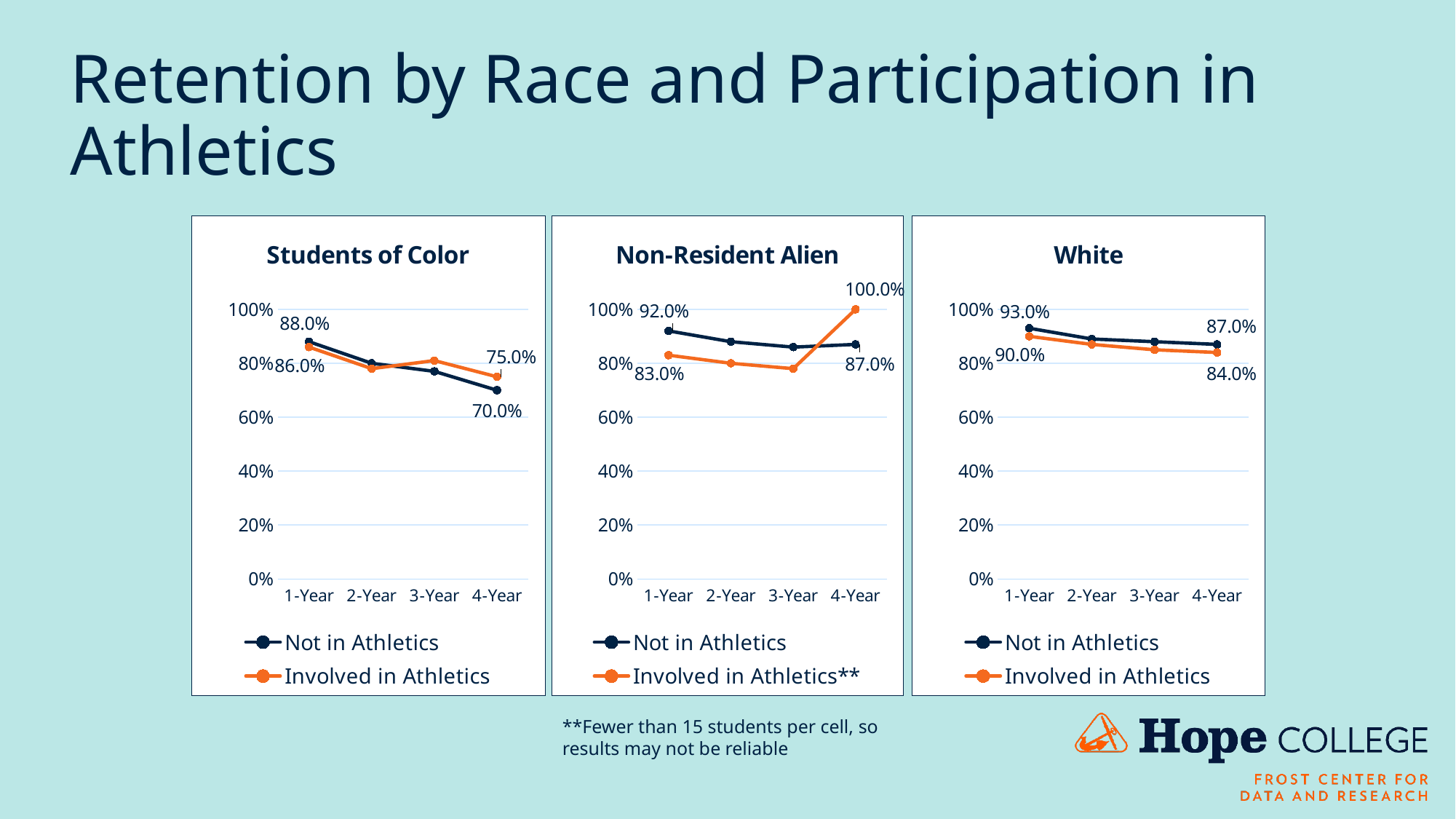
In the White chart, what is the difference between the 1-Year and 4-Year values for Involved in Athletics? 6.0% In the Students of Color chart, what is the 4-Year retention value for Not in Athletics? 70.0% In the Non-Resident Alien chart, what is the difference between the 1-Year and 4-Year values for Not in Athletics? 5.0% In the White chart, does the Not in Athletics line rise or fall from 1-Year to 4-Year? Fall What type of chart is the Non-Resident Alien chart? Line chart How many series does the legend of the Students of Color chart list? 2 In the Students of Color chart, which series has the higher 4-Year value, Not in Athletics or Involved in Athletics? Involved in Athletics In the Non-Resident Alien chart, is the 3-Year value for Involved in Athletics greater or less than 80%? less In the Non-Resident Alien chart, what is the 4-Year value for Involved in Athletics? 100.0% In the White chart, what is the 1-Year value for Not in Athletics? 93.0% How many x-axis categories does the White chart show? 4 In the Students of Color chart, what is the 1-Year retention value for Involved in Athletics? 86.0%